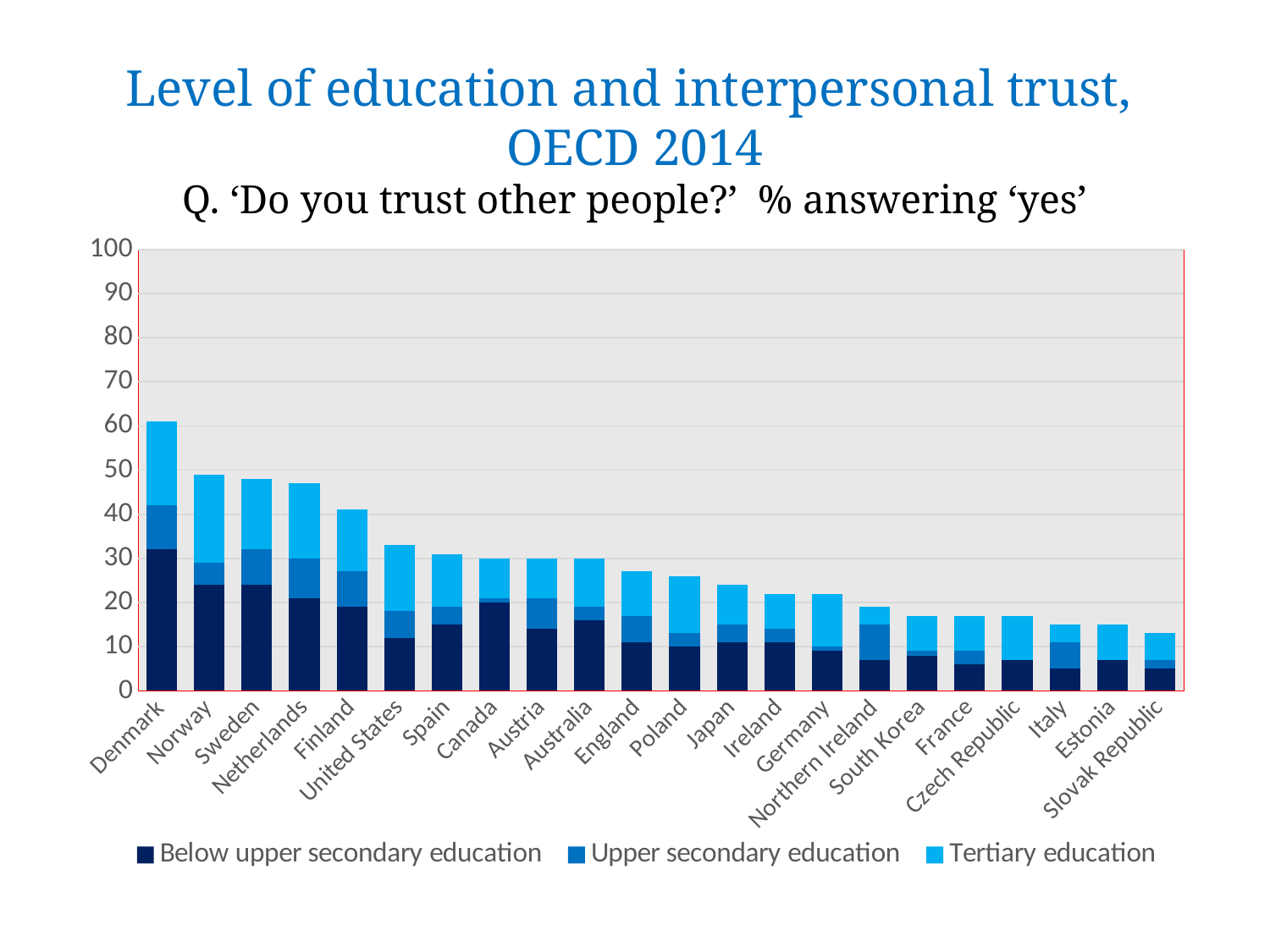
Which has the larger total bar, Finland or United States? Finland What kind of chart is shown on the slide? Stacked bar chart Is the total bar for Denmark greater or less than 50? greater How many countries are shown on the x axis of the chart? 22 Is the total bar for United States greater or less than 30? greater Is the total bar for Sweden greater or less than 50? less How many series does the legend list? 3 Which legend entry is shown in the darkest blue colour? Below upper secondary education Do the total bar heights rise or fall moving from left to right along the x axis? fall Which country has the lowest total bar? Slovak Republic Which country has the highest total bar? Denmark